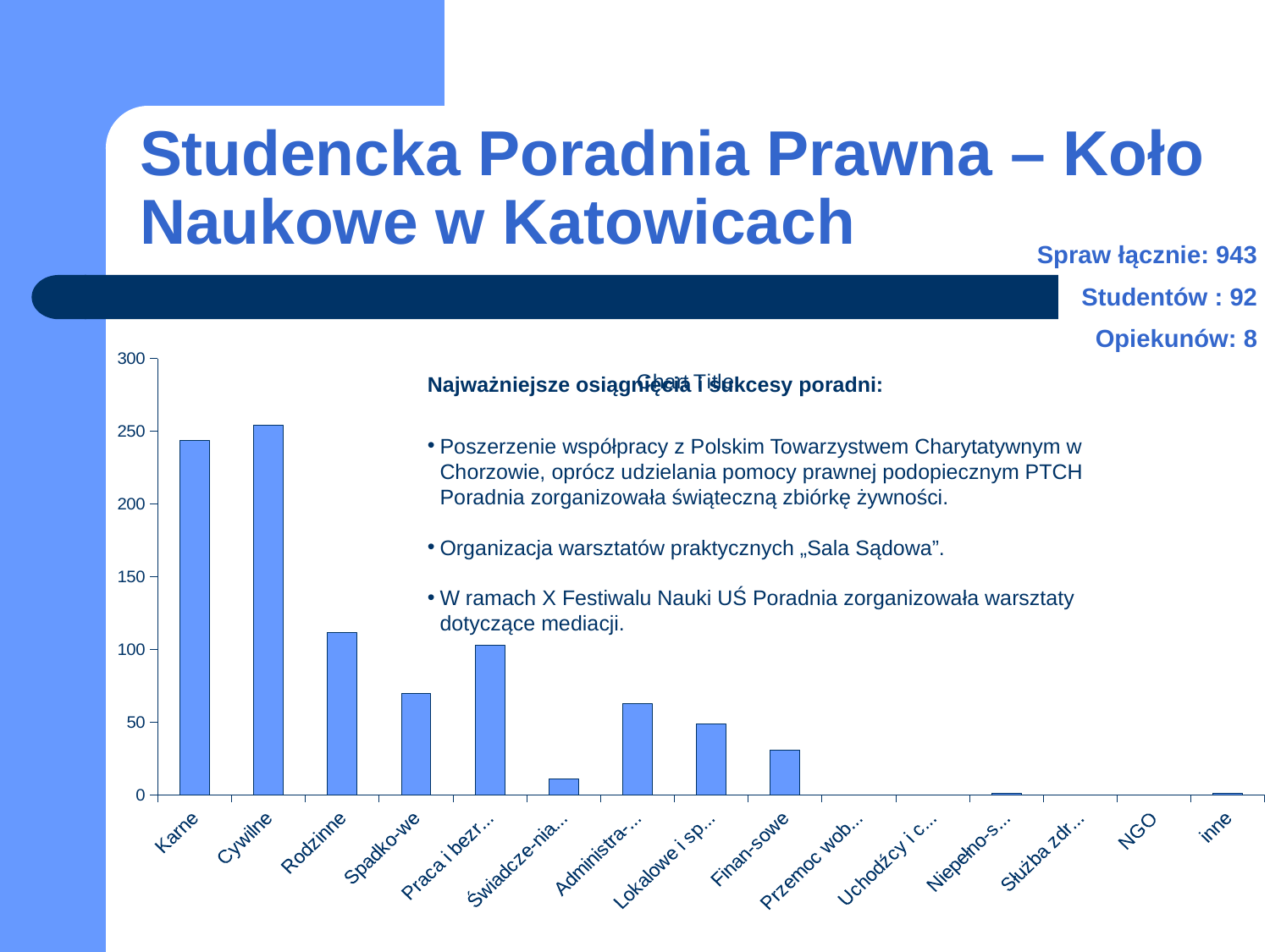
What kind of chart is shown on the slide? bar chart Which is larger, the value for Lokalowe i sp... or the value for Finan-sowe? Lokalowe i sp... Is the value for Rodzinne greater or less than 100? greater Is the value for Finan-sowe greater or less than 50? less Which category has the highest bar in the chart? Cywilne Is the value for Spadko-we greater or less than 100? less Which is larger, the value for Karne or the value for Rodzinne? Karne How many categories are shown on the x axis of the chart? 15 What is the highest value shown on the chart's vertical axis? 300